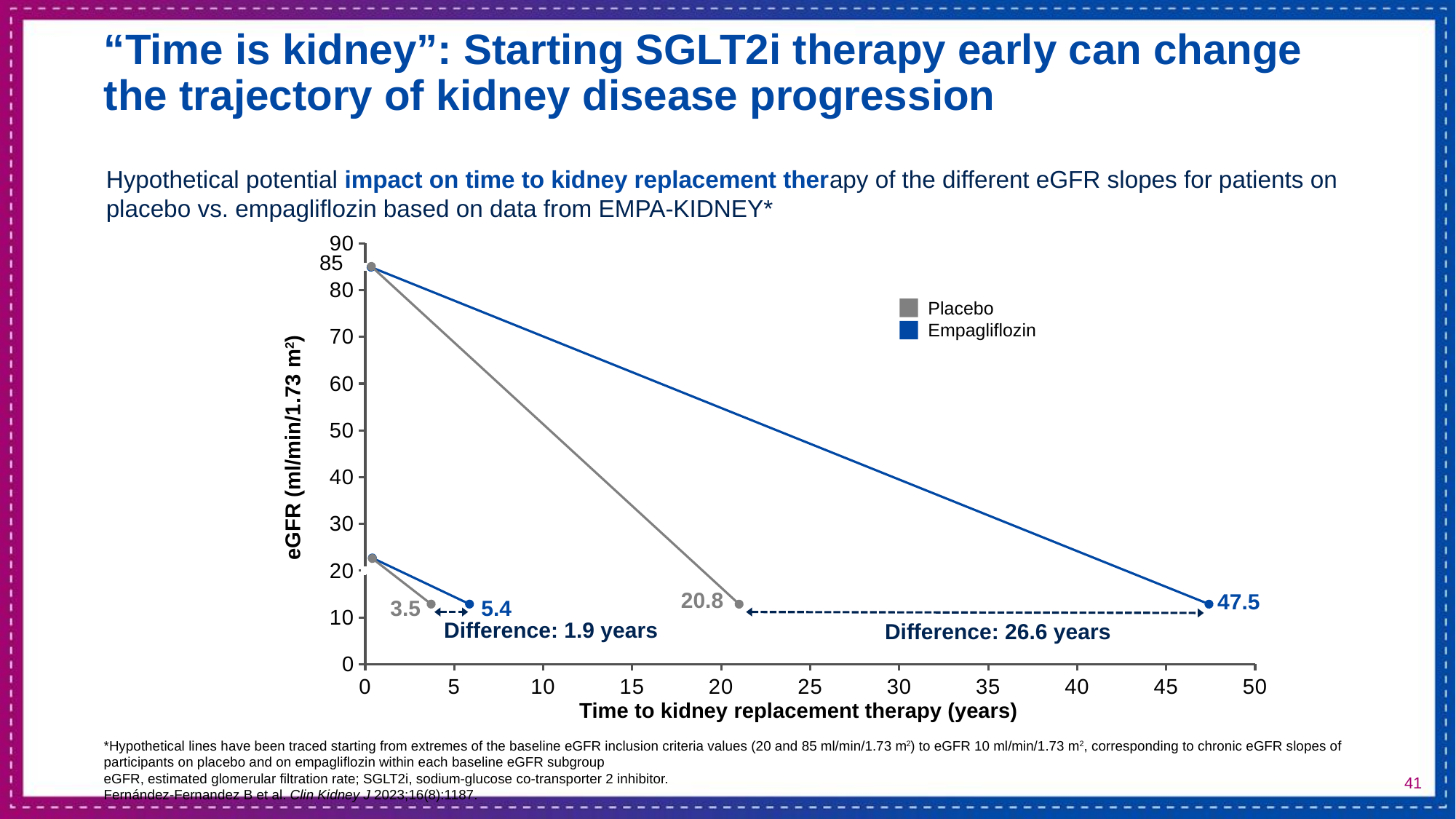
Is the time to kidney replacement therapy for the empagliflozin line starting from eGFR 85 greater or less than 45 years? greater What is the difference in years between the placebo and empagliflozin lines starting from an eGFR of 85? 26.6 years What is the time to kidney replacement therapy for the empagliflozin line starting from an eGFR of 85? 47.5 Which series reaches kidney replacement therapy later when starting from an eGFR of 85, placebo or empagliflozin? Empagliflozin Which two series are listed in the chart legend? Placebo and Empagliflozin What is the time to kidney replacement therapy for the placebo line starting from the lower baseline eGFR? 3.5 What is the label of the x axis? Time to kidney replacement therapy (years) What is the time to kidney replacement therapy for the empagliflozin line starting from the lower baseline eGFR? 5.4 How many series does the legend list? 2 What is the difference in years between the placebo and empagliflozin lines starting from the lower baseline eGFR? 1.9 years What type of chart is shown on the slide? line chart What is the time to kidney replacement therapy for the placebo line starting from an eGFR of 85? 20.8